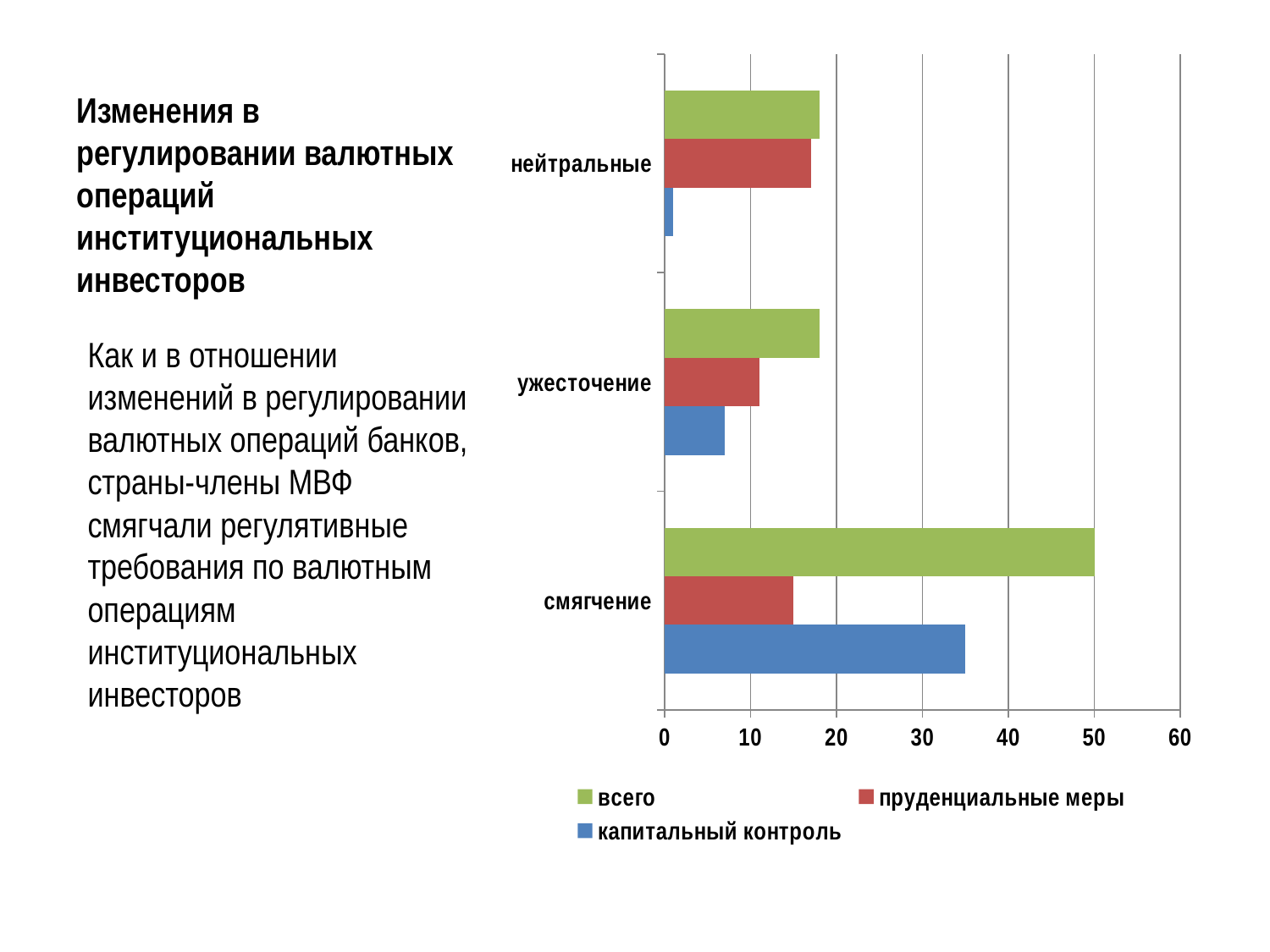
Which colour represents the series 'всего' in the legend? green Is the value of 'всего' for 'ужесточение' greater or less than 20? less Which category has the highest value for 'всего'? смягчение How many categories are shown on the chart? 3 Which category has the lowest value for 'капитальный контроль'? нейтральные What kind of chart is shown on the slide? bar chart Is the value of 'капитальный контроль' for 'смягчение' greater or less than 30? greater How many series does the legend list? 3 For the category 'смягчение', which is larger: 'капитальный контроль' or 'пруденциальные меры'? капитальный контроль Is the value of 'пруденциальные меры' for 'смягчение' greater or less than 20? less What is the value of 'всего' for the category 'смягчение'? 50